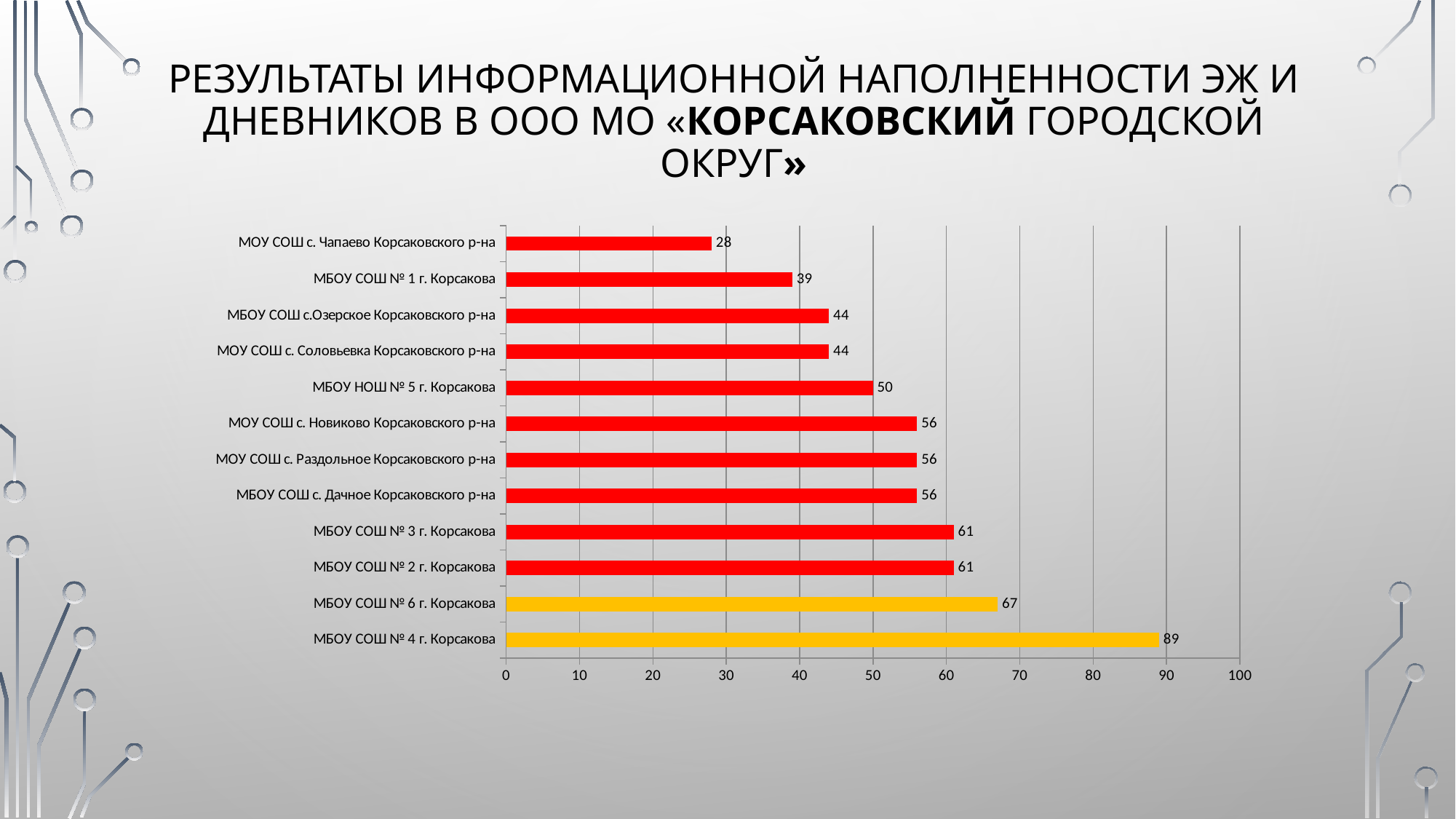
How many bars are coloured yellow rather than red? 2 Which is larger: the value for МБОУ СОШ № 3 г. Корсакова or the value for МБОУ НОШ № 5 г. Корсакова? МБОУ СОШ № 3 г. Корсакова What is the value for МБОУ НОШ № 5 г. Корсакова? 50 Which school has the lowest value? МОУ СОШ с. Чапаево Корсаковского р-на What is the value for МБОУ СОШ № 6 г. Корсакова? 67 What is the value for МОУ СОШ с. Чапаево Корсаковского р-на? 28 How many schools are shown in the chart? 12 What is the difference between the values for МБОУ СОШ № 1 г. Корсакова and МОУ СОШ с. Чапаево Корсаковского р-на? 11 Which school has the highest value? МБОУ СОШ № 4 г. Корсакова What is the difference between the values for МБОУ СОШ № 4 г. Корсакова and МБОУ СОШ № 6 г. Корсакова? 22 What kind of chart is shown on the slide? Bar chart What is the value for МБОУ СОШ № 4 г. Корсакова? 89